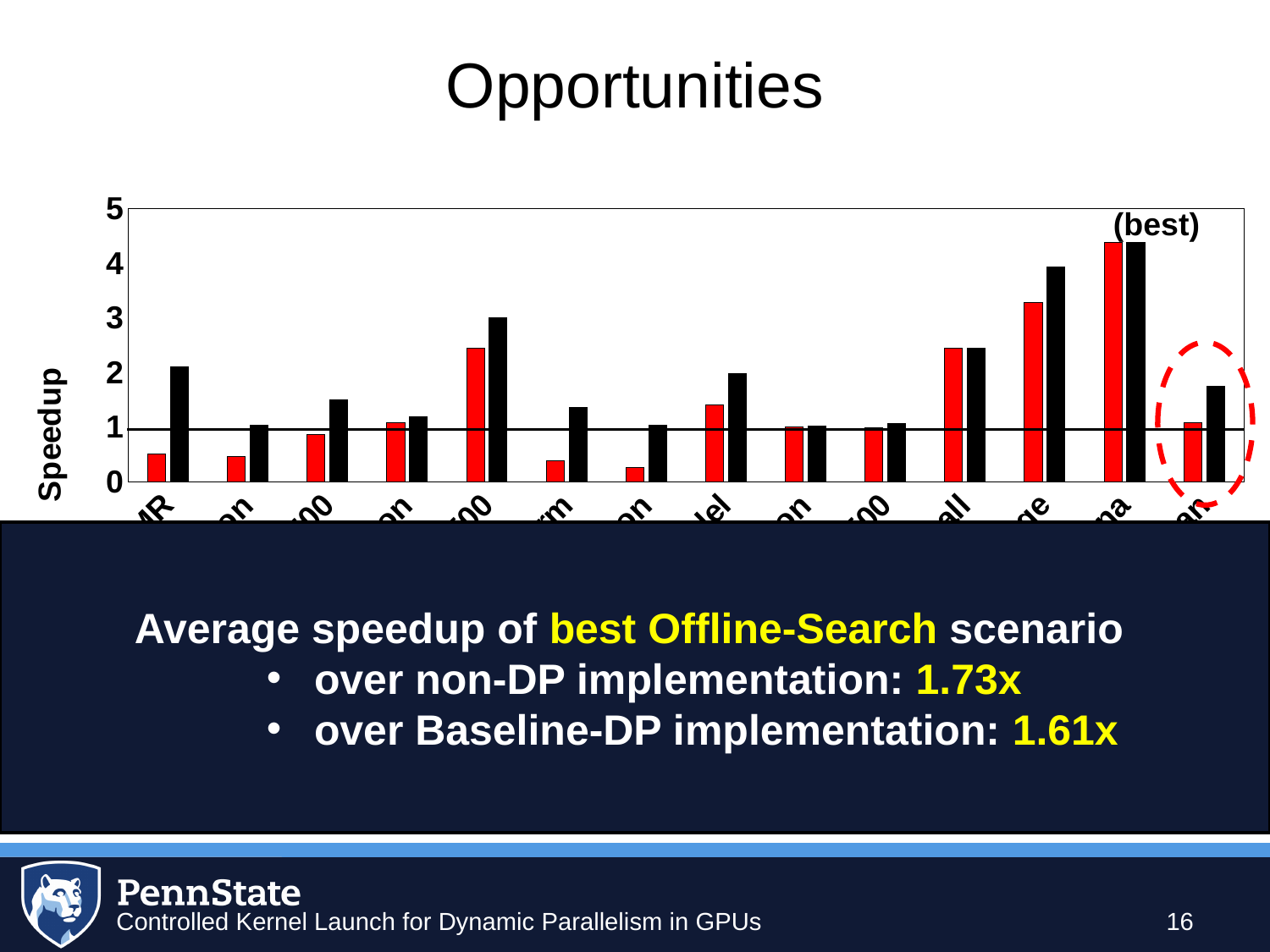
Is the red bar in the group marked "(best)" greater or less than 4? greater In the leftmost group of bars, which bar is taller, the red one or the black one? the black one What kind of chart is shown on the slide? bar chart Is the black bar in the rightmost (circled) group greater or less than 1? greater Is the red bar in the leftmost group greater or less than 1? less What is the highest tick value shown on the y axis? 5 How many groups of bars (categories) are plotted along the x axis? 14 Which group of bars has the highest speedup values? the group marked "(best)", second from the right What is the label on the y axis of the chart? Speedup At what value is the horizontal reference line drawn across the chart? 1 In the rightmost group of bars (circled with a red dashed line), which bar is taller, the red one or the black one? the black one